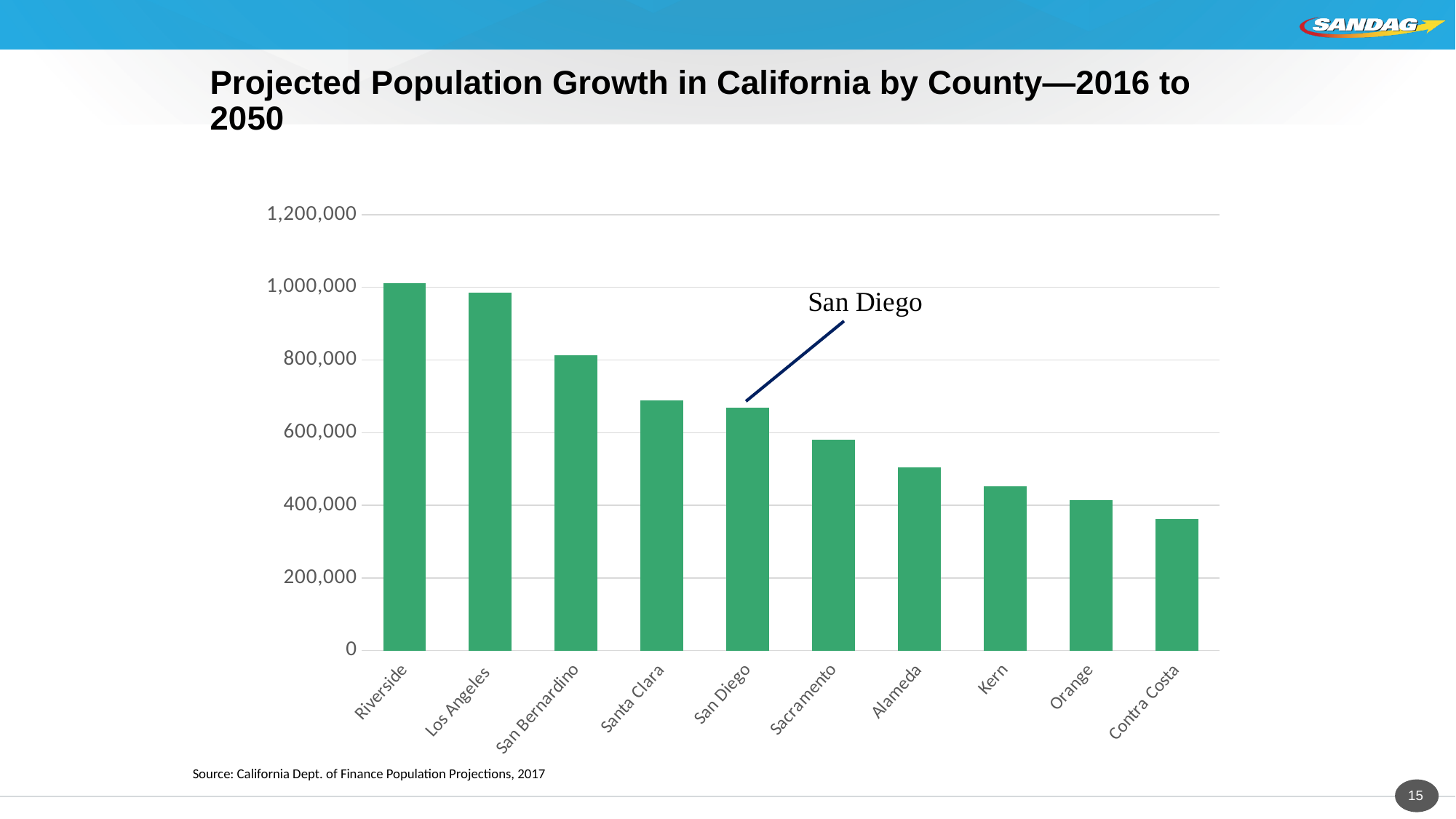
Which county has the lowest projected population growth? Contra Costa Is the value for Contra Costa greater or less than 400,000? less Which has the larger projected population growth, San Bernardino or Santa Clara? San Bernardino Which county has the highest projected population growth? Riverside Which has the larger projected population growth, Sacramento or Alameda? Sacramento How many counties are shown on the chart? 10 Is the value for San Diego greater or less than 600,000? greater What kind of chart is shown on the slide? Bar chart Which county is called out with an annotation and arrow on the chart? San Diego Is the value for Kern greater or less than 400,000? greater Do the values rise or fall moving from left to right along the x axis? Fall